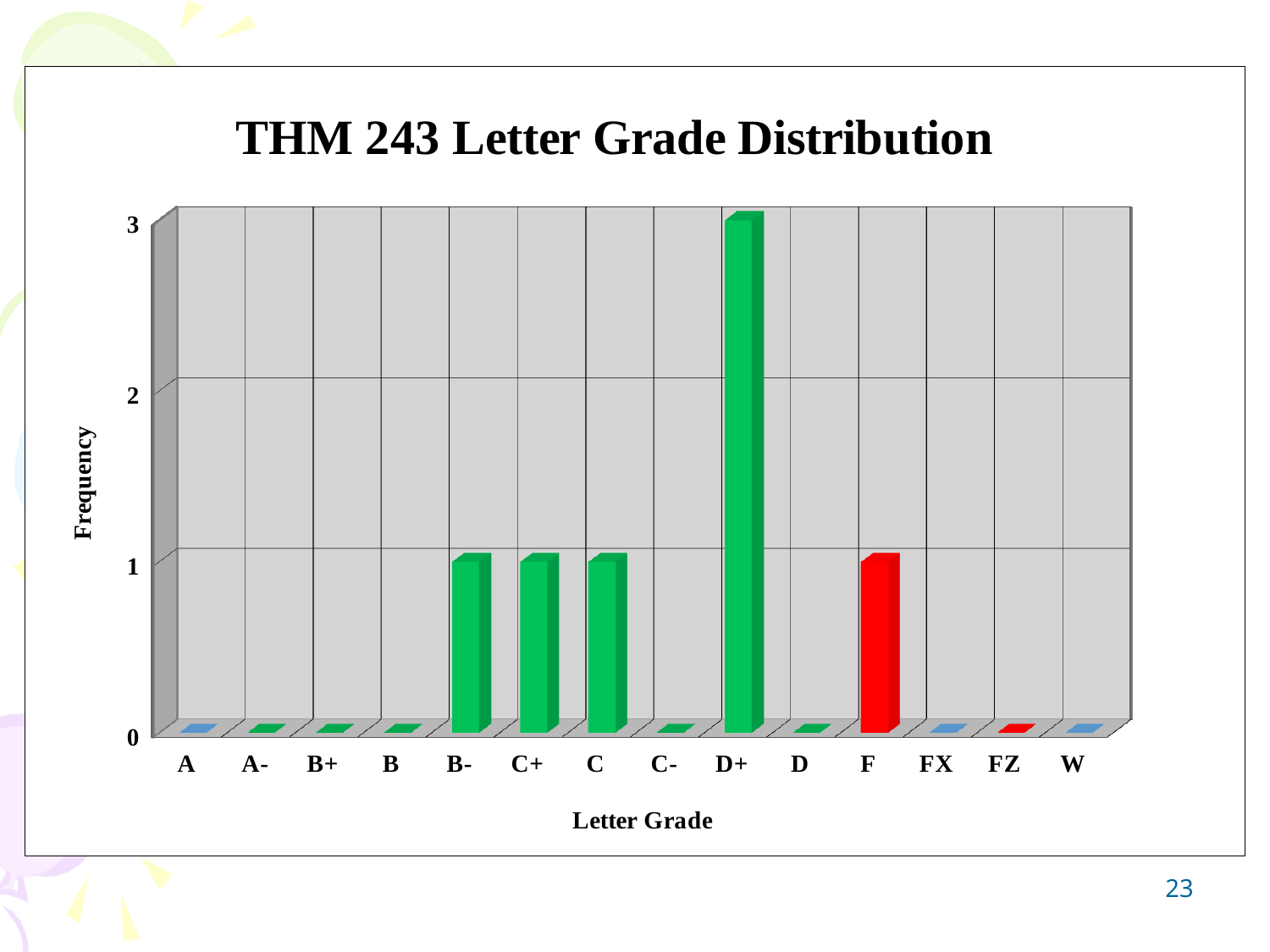
How many letter grade categories are shown on the x axis? 14 Is the frequency for D+ greater or less than 2? greater What is the frequency for the B- letter grade? 1 What is the frequency for the A letter grade? 0 What is the frequency for the D+ letter grade? 3 What kind of chart is shown on the slide? bar chart What is the title of the chart? THM 243 Letter Grade Distribution Which has a higher frequency, D+ or F? D+ What is the difference in frequency between D+ and C? 2 What is the label of the vertical axis? Frequency Which letter grade has the highest frequency? D+ What is the frequency for the F letter grade? 1